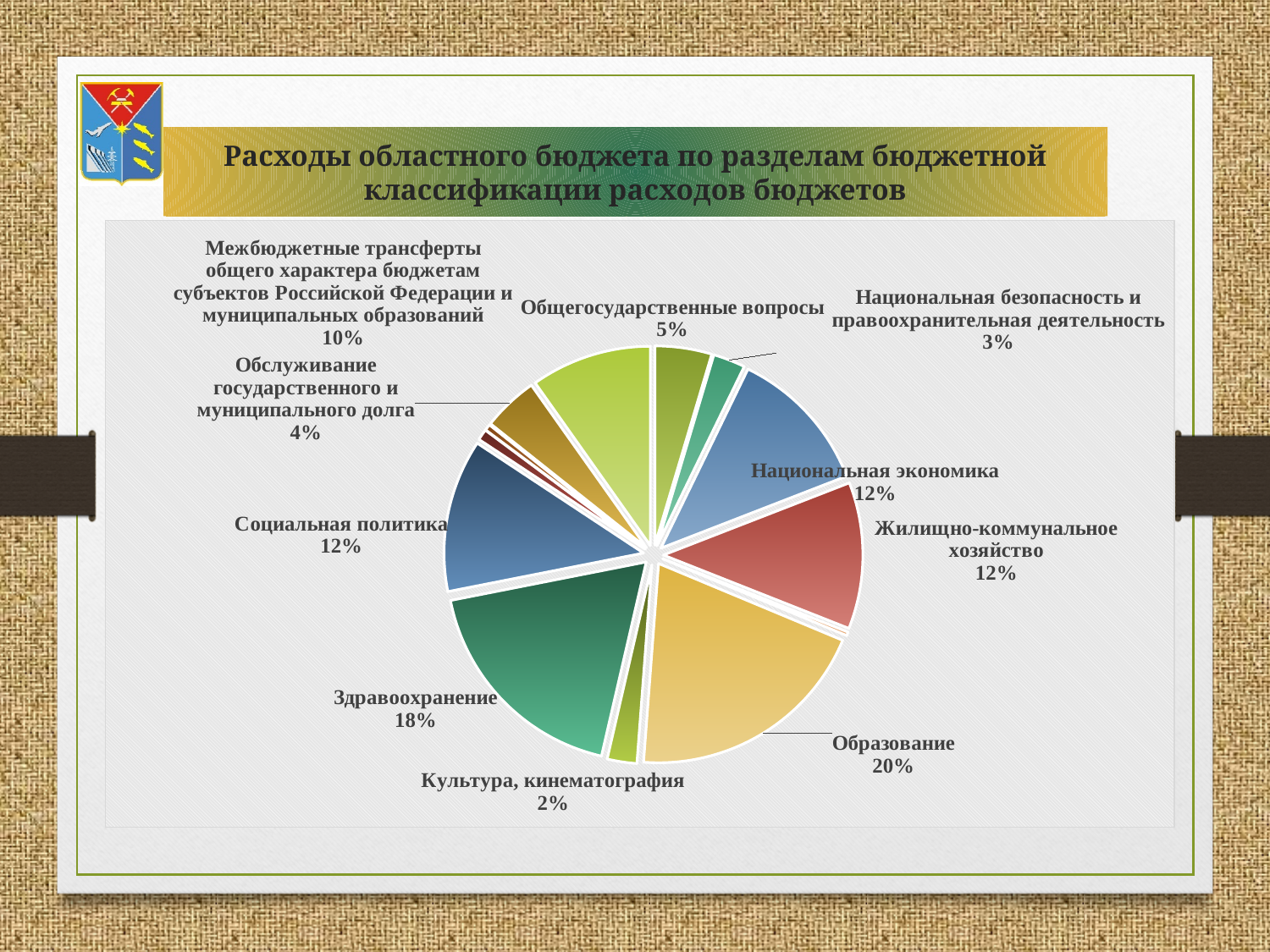
Which labeled category has the largest share of the pie? Образование What is the value shown for Социальная политика? 12% Which is larger, the share for Общегосударственные вопросы or the share for Национальная безопасность и правоохранительная деятельность? Общегосударственные вопросы What type of chart is shown on the slide? pie chart What is the value shown for Обслуживание государственного и муниципального долга? 4% What is the value shown for Здравоохранение? 18% What share of the pie does Образование account for? 20% What is the value shown for Межбюджетные трансферты общего характера бюджетам субъектов Российской Федерации и муниципальных образований? 10% What is the title of the chart on the slide? Расходы областного бюджета по разделам бюджетной классификации расходов бюджетов What is the value shown for Культура, кинематография? 2% What is the difference between the shares of Образование and Здравоохранение? 2% What is the value shown for Национальная безопасность и правоохранительная деятельность? 3%